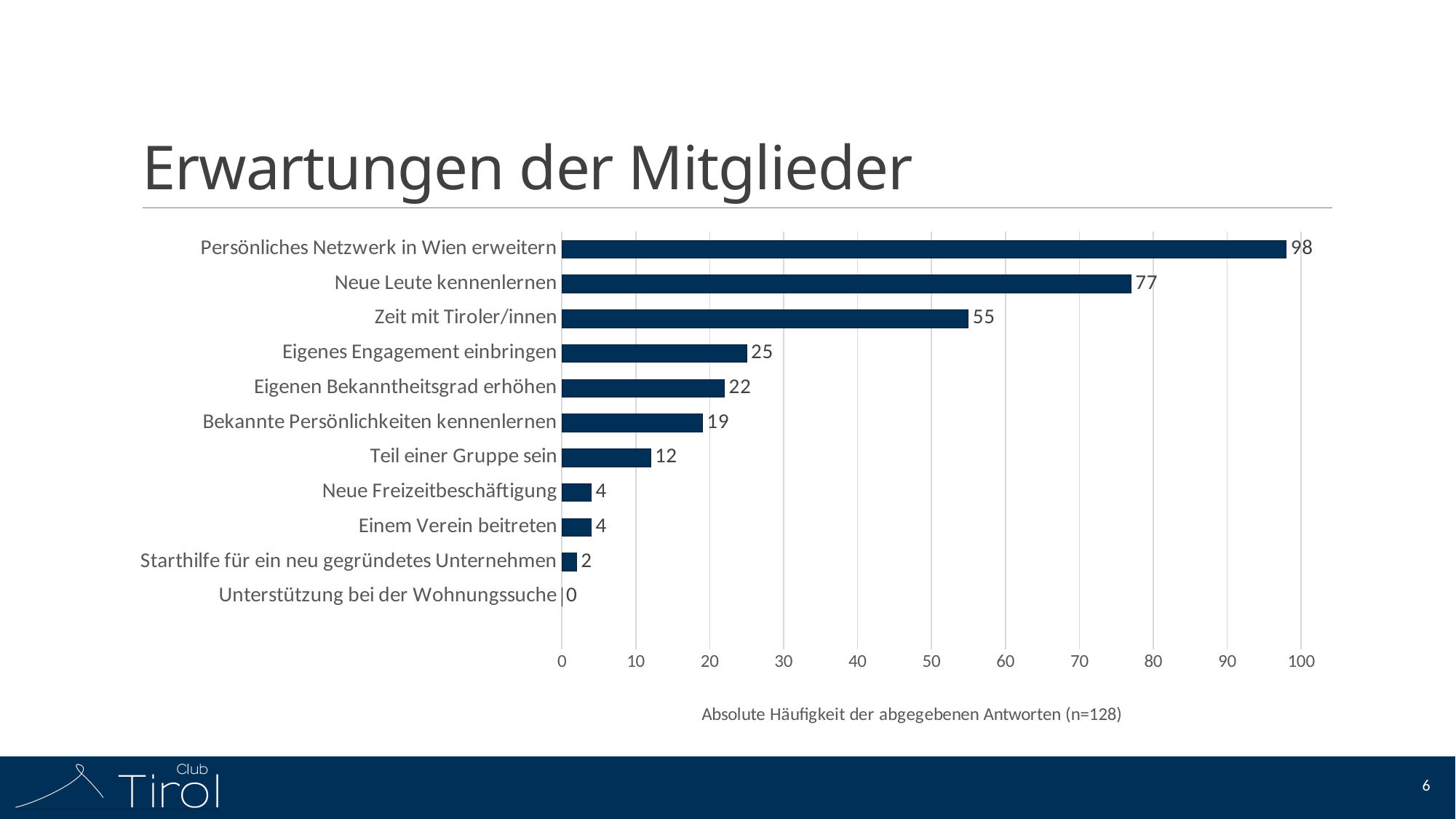
What is the x-axis label of the chart? Absolute Häufigkeit der abgegebenen Antworten (n=128) What is the value for "Teil einer Gruppe sein"? 12 What is the value for "Zeit mit Tiroler/innen"? 55 What is the difference between "Bekannte Persönlichkeiten kennenlernen" and "Starthilfe für ein neu gegründetes Unternehmen"? 17 Which is larger: "Eigenes Engagement einbringen" or "Eigenen Bekanntheitsgrad erhöhen"? Eigenes Engagement einbringen Which category has the lowest value? Unterstützung bei der Wohnungssuche Which category has the highest value? Persönliches Netzwerk in Wien erweitern What kind of chart is shown on the slide? Bar chart How many categories are shown in the chart? 11 What is the value for "Persönliches Netzwerk in Wien erweitern"? 98 Is the value for "Neue Leute kennenlernen" greater or less than 70? greater What is the difference between "Persönliches Netzwerk in Wien erweitern" and "Neue Leute kennenlernen"? 21